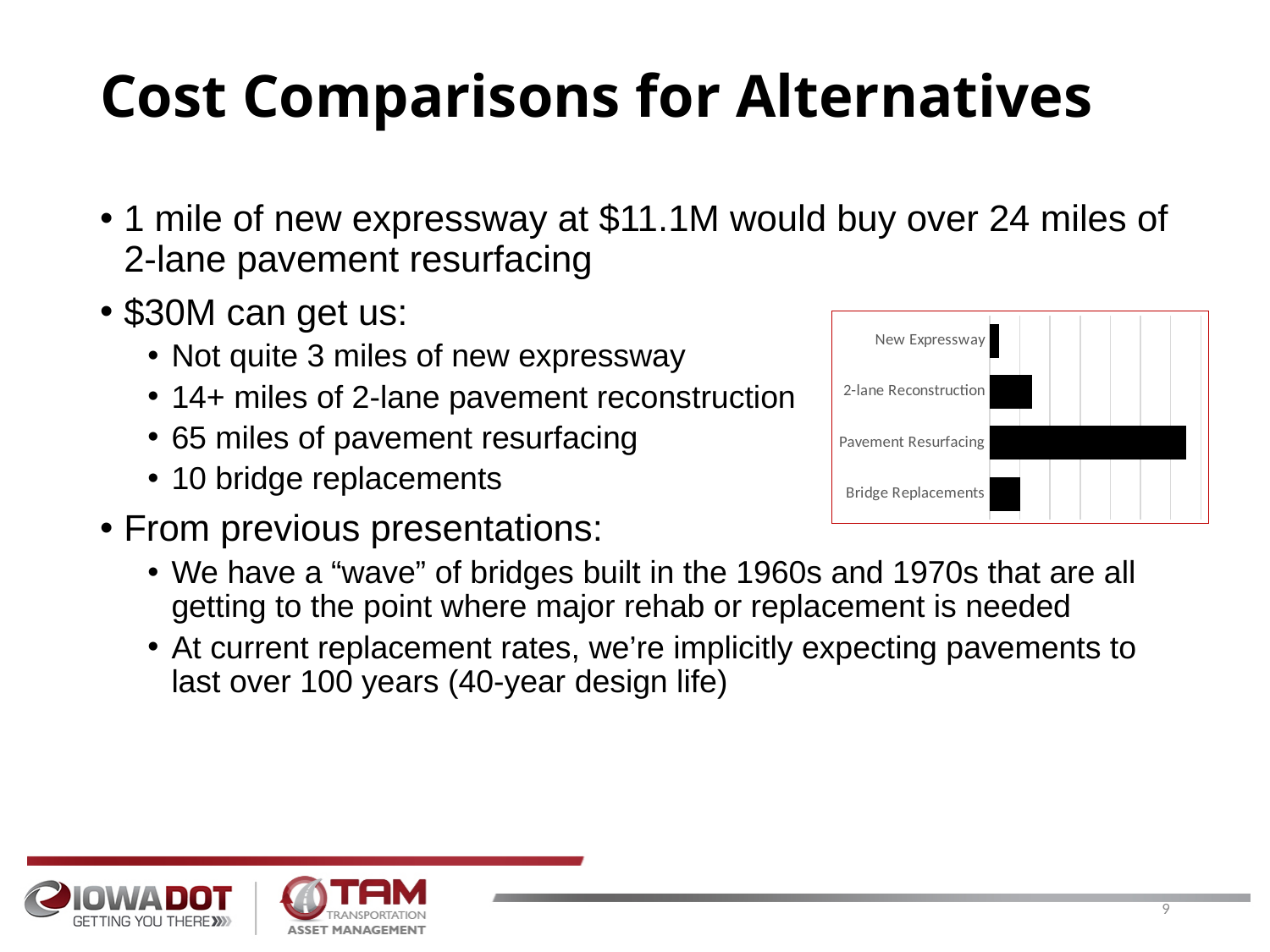
How many categories does the bar chart show? 4 Which category has the longest bar in the chart? Pavement Resurfacing Which category has the shortest bar in the chart? New Expressway Which bar is shorter, New Expressway or Bridge Replacements? New Expressway Which category is listed at the top of the bar chart? New Expressway Are the bars in the chart drawn horizontally or vertically? horizontally Which bar is longer, Pavement Resurfacing or Bridge Replacements? Pavement Resurfacing Which bar is longer, 2-lane Reconstruction or New Expressway? 2-lane Reconstruction What kind of chart is shown on the slide? bar chart